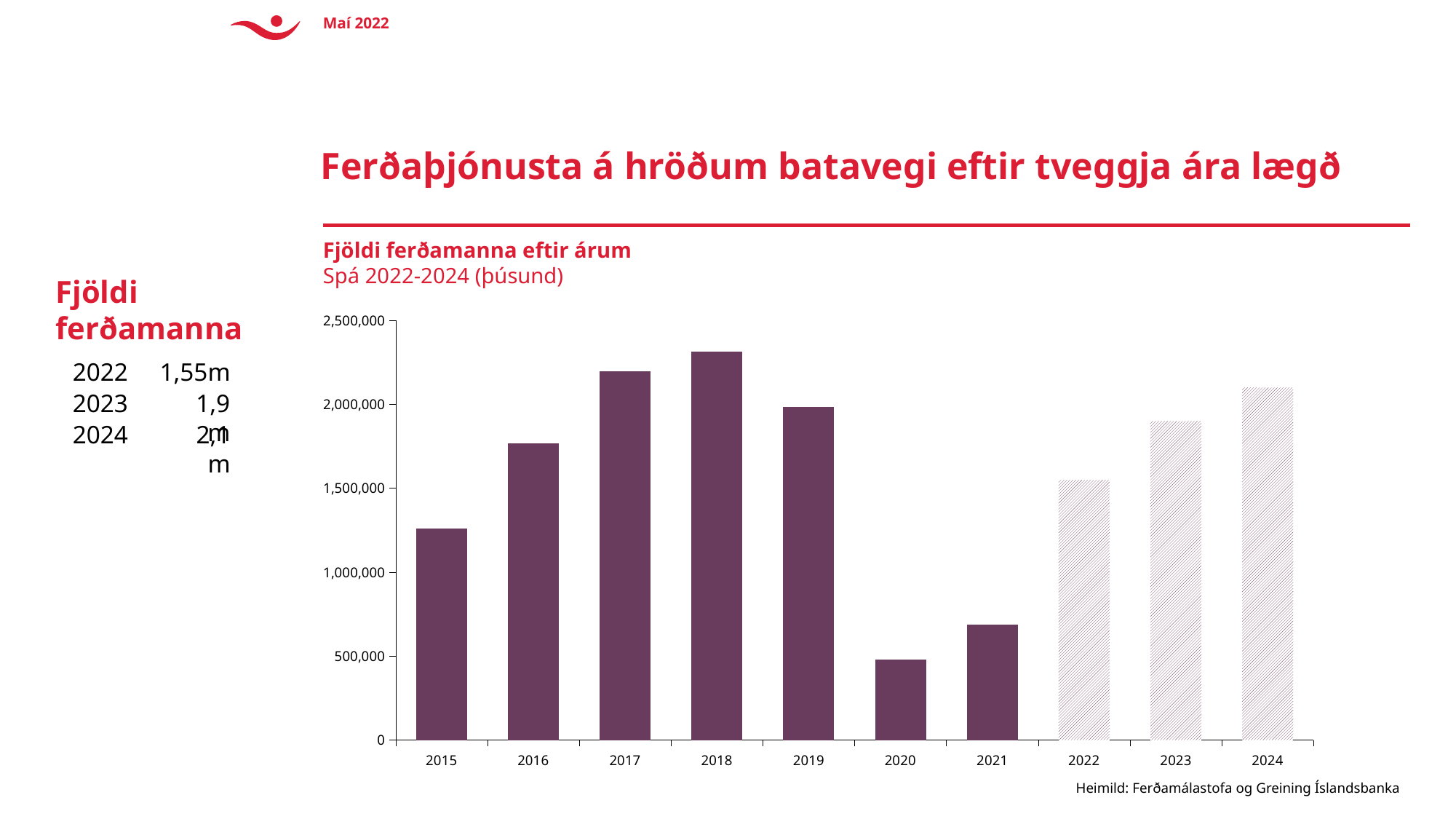
What kind of chart is shown on the slide? Bar chart Do the values rise or fall from 2015 to 2018? rise Is the value for 2021 greater or less than 500,000? greater Which year has the highest number of tourists in the chart? 2018 What is the title of the chart? Fjöldi ferðamanna eftir árum Is the value for 2023 greater or less than 2,000,000? less Is the value for 2020 greater or less than 1,000,000? less Which year has the lowest number of tourists in the chart? 2020 How many years are shown on the x axis of the chart? 10 Which year has the larger value, 2016 or 2017? 2017